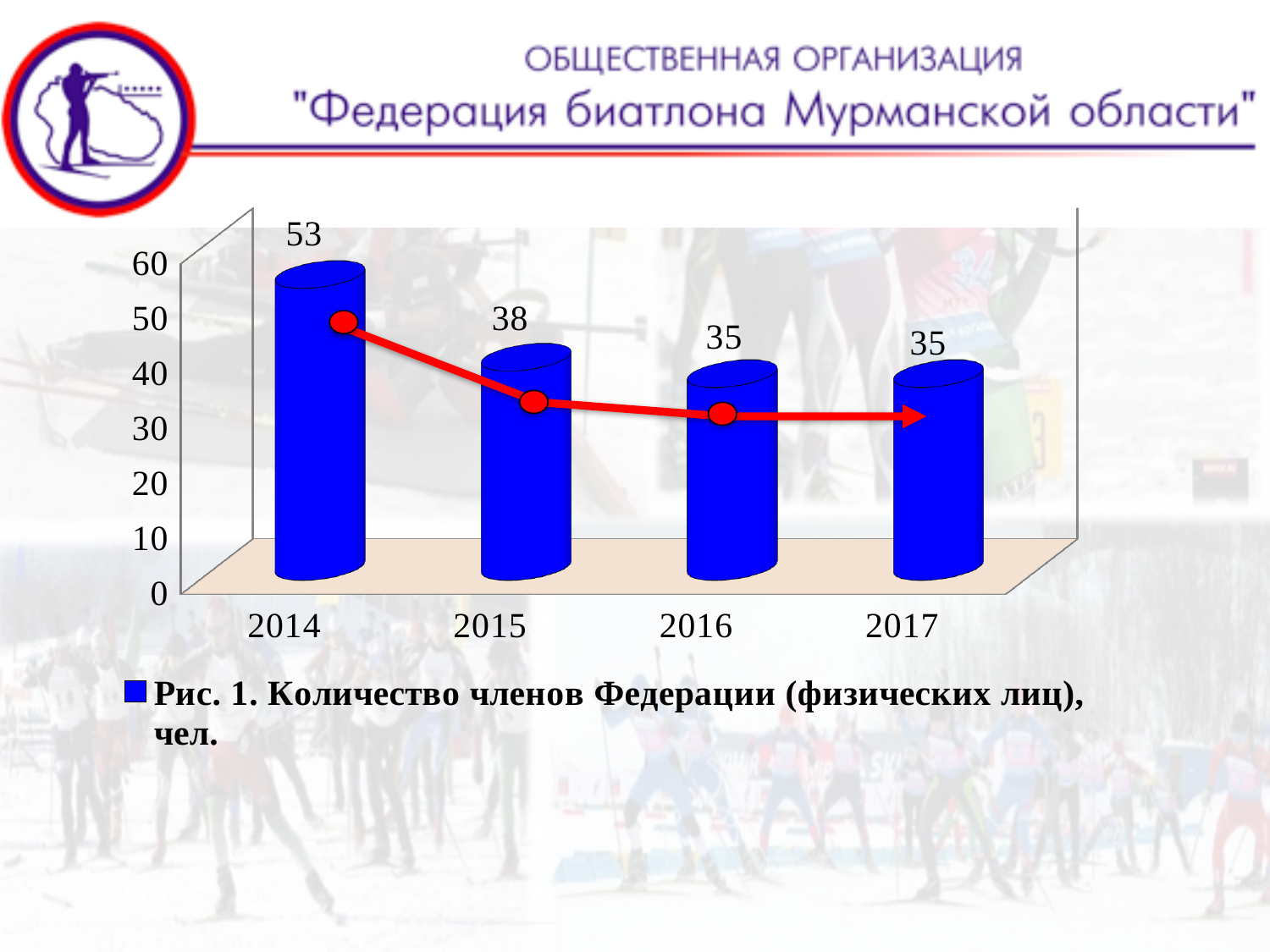
What is the value for 2014? 53 Do the values rise or fall from 2014 to 2016? fall What kind of chart is this? bar chart What is the value for 2017? 35 How many years are shown on the x axis? 4 Which is larger, the value for 2015 or the value for 2016? 2015 What is the difference between the values for 2014 and 2017? 18 What is the difference between the values for 2014 and 2015? 15 Which year has the highest value? 2014 What is the value for 2016? 35 Is the value for 2014 greater or less than 50? greater What is the value for 2015? 38